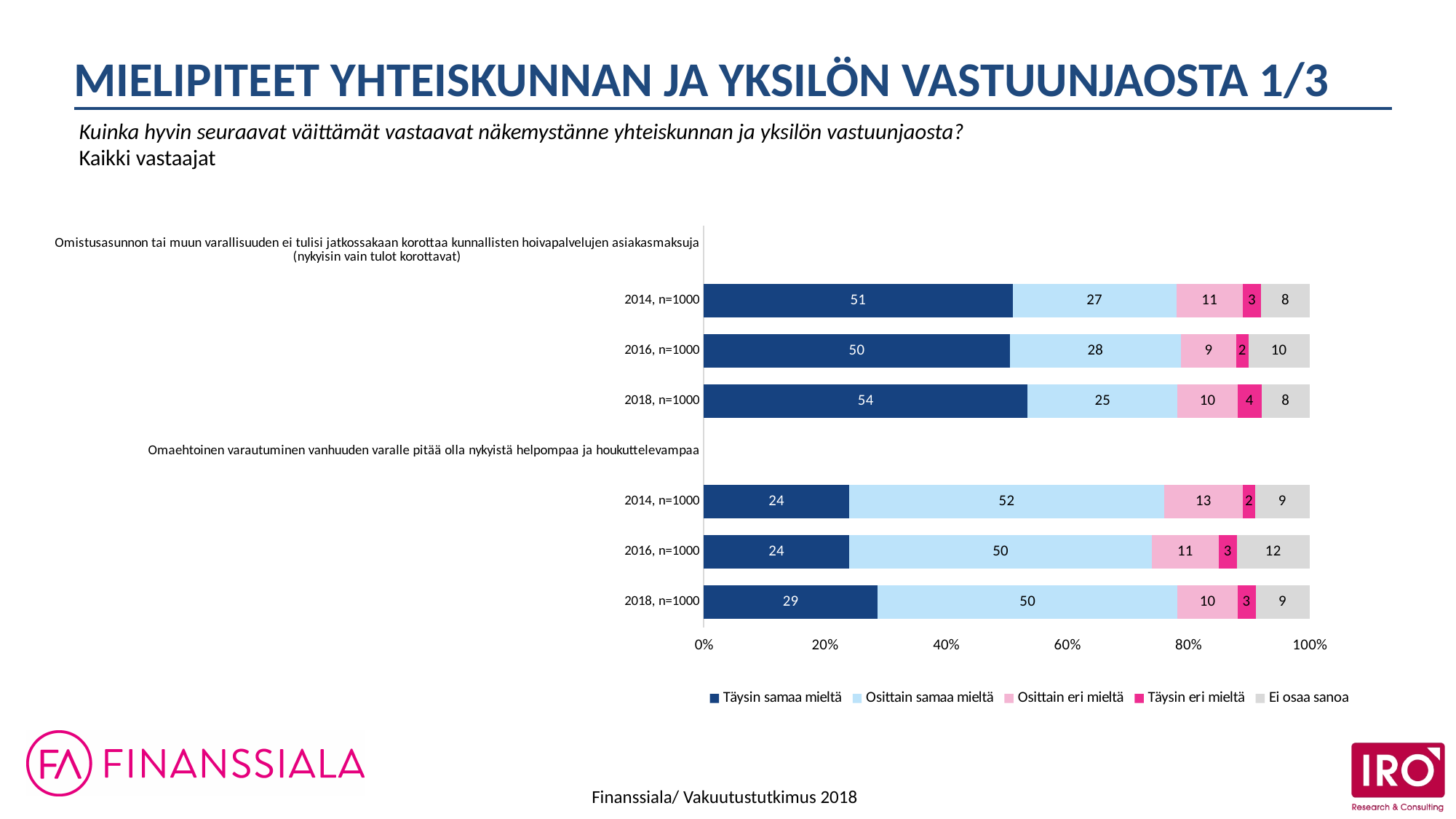
What is the 'Täysin samaa mieltä' value for the 2018, n=1000 bar under the statement 'Omistusasunnon tai muun varallisuuden ei tulisi jatkossakaan korottaa kunnallisten hoivapalvelujen asiakasmaksuja'? 54 Which legend entry is shown in dark blue? Täysin samaa mieltä How many series does the legend list? 5 What kind of chart is shown on the slide? Stacked bar chart What is the total of the 2016, n=1000 bar under the statement 'Omistusasunnon tai muun varallisuuden ei tulisi jatkossakaan korottaa kunnallisten hoivapalvelujen asiakasmaksuja'? 99 Which year has the highest 'Täysin samaa mieltä' value under the statement 'Omistusasunnon tai muun varallisuuden ei tulisi jatkossakaan korottaa kunnallisten hoivapalvelujen asiakasmaksuja'? 2018, n=1000 What is the 'Ei osaa sanoa' value for the 2016, n=1000 bar under the statement 'Omaehtoinen varautuminen vanhuuden varalle pitää olla nykyistä helpompaa ja houkuttelevampaa'? 12 Under the statement 'Omaehtoinen varautuminen vanhuuden varalle pitää olla nykyistä helpompaa ja houkuttelevampaa', is the 'Osittain eri mieltä' value larger for 2014 or 2018? 2014 How many bars are plotted in the chart? 6 What is the difference between the 'Täysin samaa mieltä' values for 2018 and 2016 under the statement 'Omaehtoinen varautuminen vanhuuden varalle pitää olla nykyistä helpompaa ja houkuttelevampaa'? 5 Which year has the lowest 'Täysin eri mieltä' value under the statement 'Omistusasunnon tai muun varallisuuden ei tulisi jatkossakaan korottaa kunnallisten hoivapalvelujen asiakasmaksuja'? 2016, n=1000 What is the 'Osittain samaa mieltä' value for the 2014, n=1000 bar under the statement 'Omaehtoinen varautuminen vanhuuden varalle pitää olla nykyistä helpompaa ja houkuttelevampaa'? 52